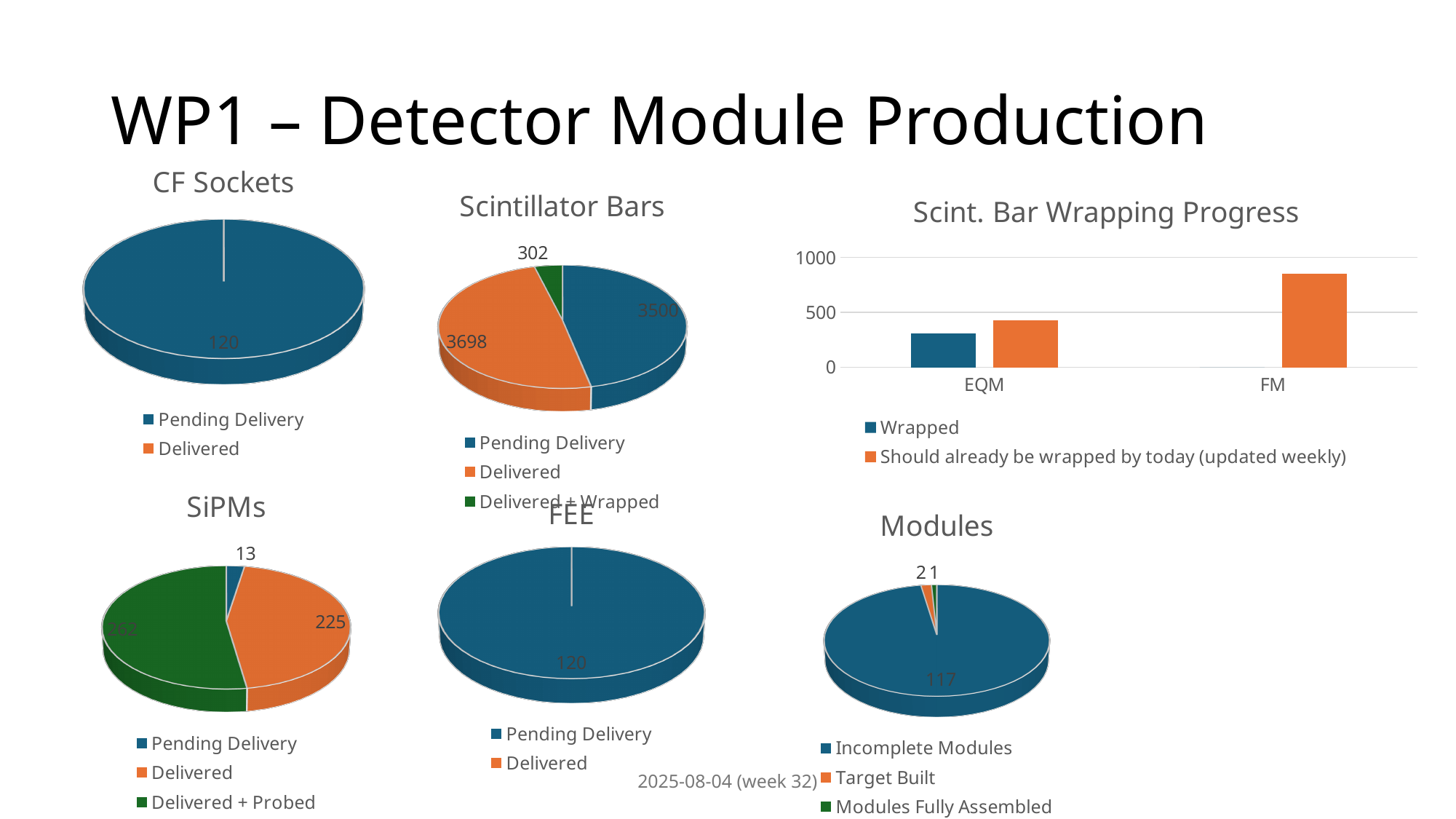
What kind of chart is the Scint. Bar Wrapping Progress chart? bar chart In the SiPMs pie chart, which is larger: Delivered or Delivered + Probed? Delivered + Probed In the Scintillator Bars pie chart, what is the difference between the Delivered and Pending Delivery values? 198 In the Scintillator Bars pie chart, which category has the smallest slice? Delivered + Wrapped In the Scintillator Bars pie chart, what is the value for Delivered? 3698 In the Modules pie chart, what is the value for Incomplete Modules? 117 In the Scint. Bar Wrapping Progress chart, is the 'Should already be wrapped by today' value for FM greater or less than 500? greater In the SiPMs pie chart, which category has the smallest slice? Pending Delivery In the Scint. Bar Wrapping Progress chart, is the Wrapped value for EQM greater or less than 500? less How many series does the legend of the Scint. Bar Wrapping Progress chart list? 2 In the Scintillator Bars pie chart, what is the total of all three slices? 7500 In the SiPMs pie chart, what is the value for Delivered + Probed? 262